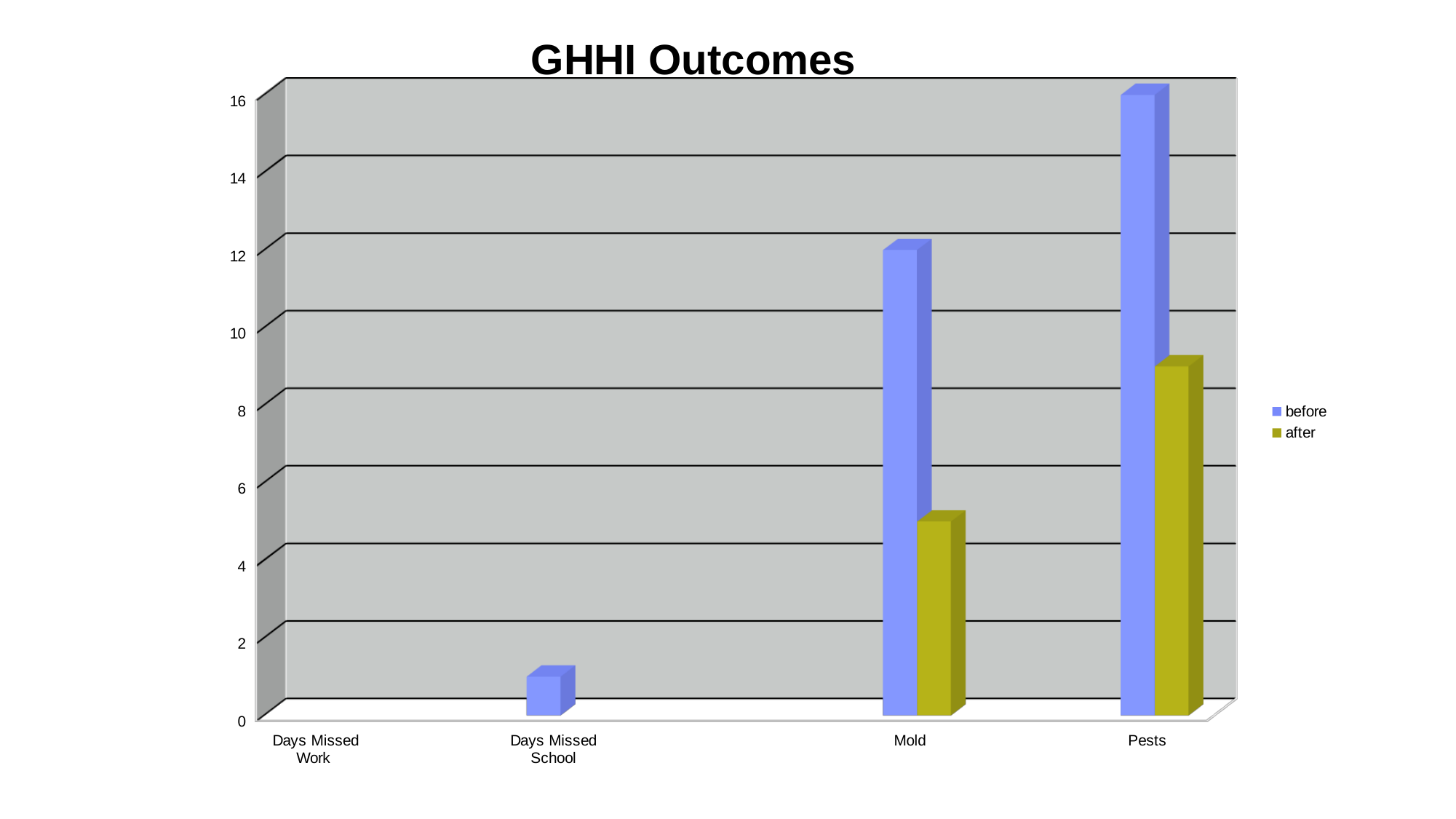
What is the title of the chart? GHHI Outcomes What kind of chart is shown on the slide? bar chart For Mold, which is larger: the 'before' value or the 'after' value? before Is the 'after' value for Mold greater or less than 6? less Which is larger: the 'before' value for Pests or the 'before' value for Mold? Pests Which category has the highest 'before' value? Pests Is the 'after' value for Pests greater or less than 8? greater How many categories are shown on the x axis? 4 Is the 'before' value for Mold greater or less than 10? greater How many series does the legend list? 2